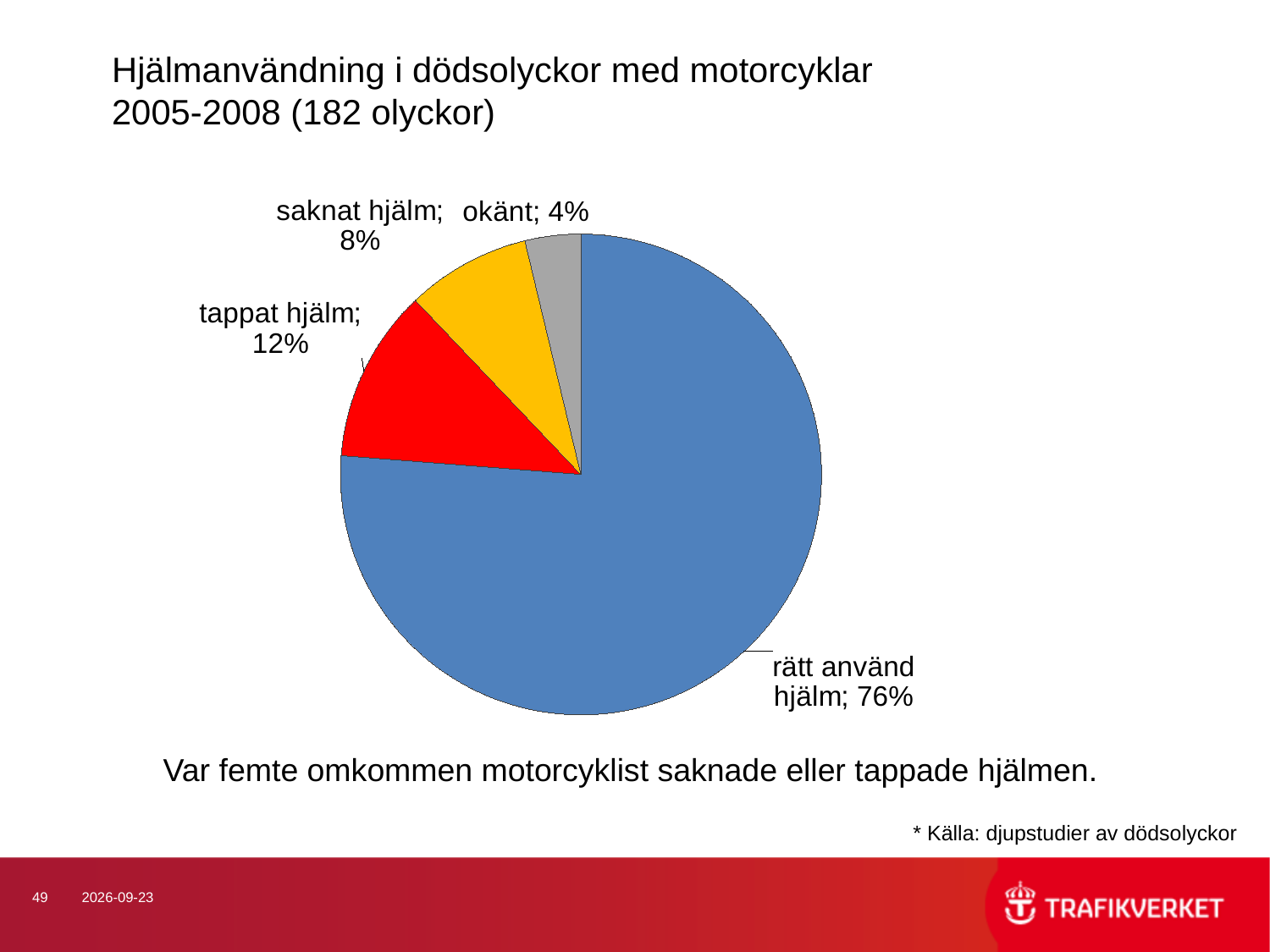
What share of the pie does "tappat hjälm" represent? 12% What colour is the slice for "tappat hjälm"? red Which category has the smallest slice of the pie? okänt What is the difference in percentage points between "tappat hjälm" and "saknat hjälm"? 4 What type of chart is shown on the slide? pie chart What share of the pie does "okänt" represent? 4% Which is larger, the share for "saknat hjälm" or the share for "okänt"? saknat hjälm How many slices does the pie chart have? 4 Which category has the largest slice of the pie? rätt använd hjälm What share of the pie does "saknat hjälm" represent? 8% What is the combined share of "saknat hjälm" and "tappat hjälm"? 20%